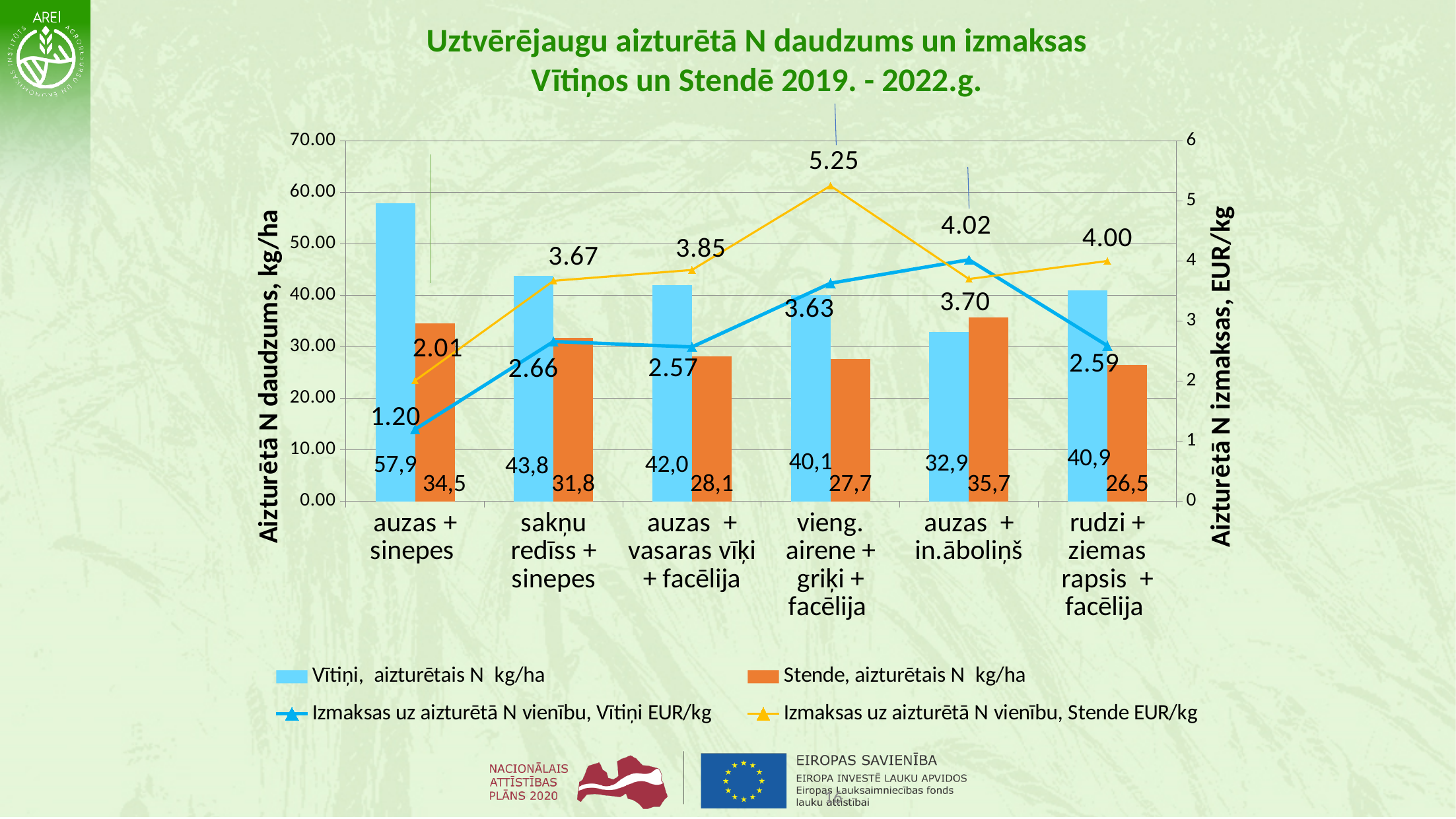
What is the Vītiņi retained N value (kg/ha) for auzas + sinepes? 57,9 What kind of chart is this? Combined bar and line chart What is the difference between the Vītiņi and Stende retained N values for auzas + sinepes? 23,4 Which cover crop mix has the lowest Stende retained N (kg/ha)? rudzi + ziemas rapsis + facēlija What is the label of the right-hand vertical axis? Aizturētā N izmaksas, EUR/kg What is the Stende retained N value (kg/ha) for auzas + in.āboliņš? 35,7 What is the cost per unit of retained N for Vītiņi (EUR/kg) for auzas + sinepes? 1.20 How many cover crop mixes are shown on the x axis? 6 For auzas + in.āboliņš, which is larger: the Vītiņi retained N or the Stende retained N? Stende retained N How many series does the legend list? 4 Which cover crop mix has the highest Vītiņi retained N (kg/ha)? auzas + sinepes What is the cost per unit of retained N for Stende (EUR/kg) for vieng. airene + griķi + facēlija? 5.25